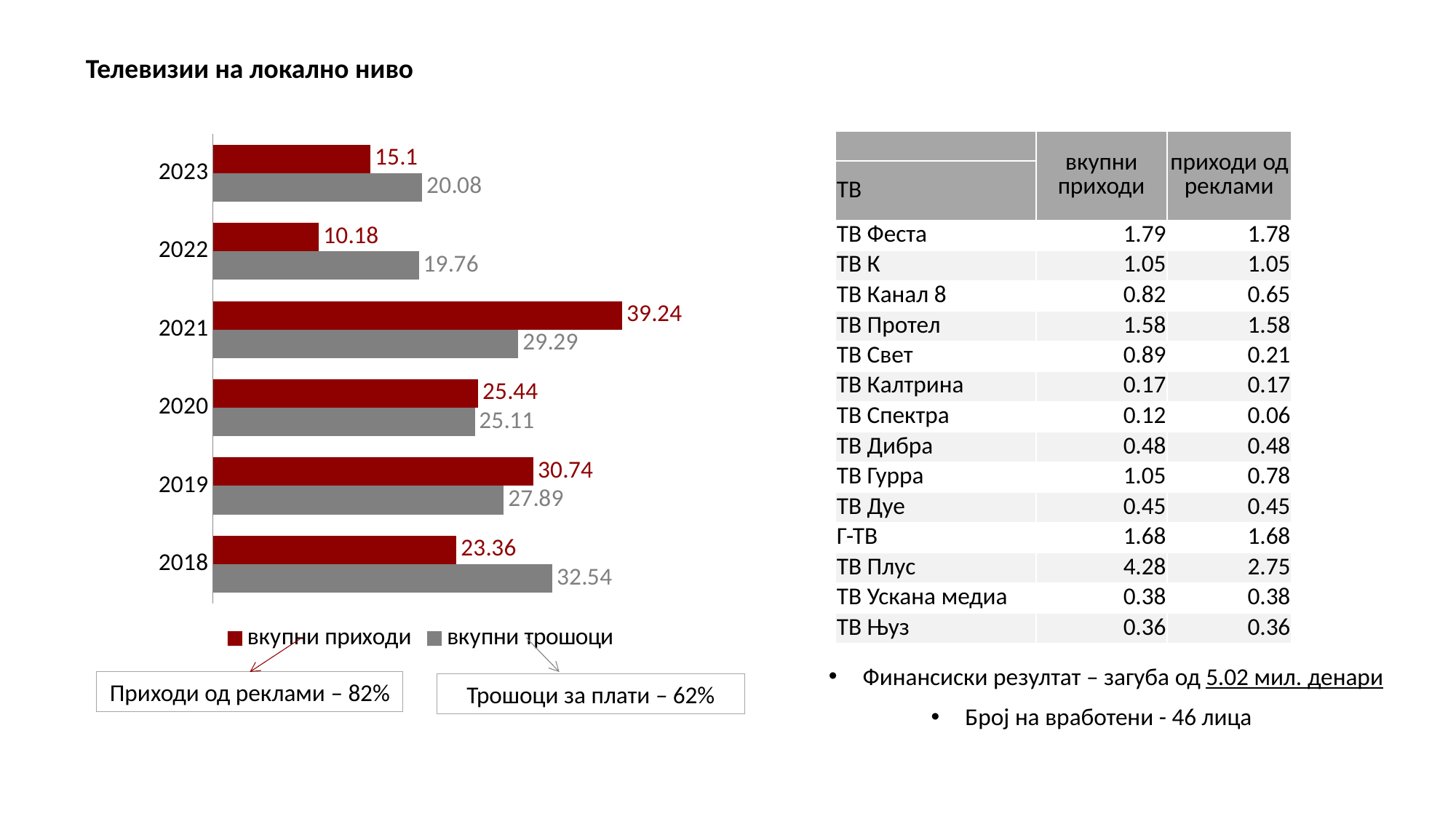
What is the value of вкупни трошоци for 2018? 32.54 What is the value of вкупни приходи for 2022? 10.18 How many series does the chart legend list? 2 In 2019, which is larger: вкупни приходи or вкупни трошоци? вкупни приходи What type of chart is shown on the slide? bar chart How many years are shown on the chart? 6 What is the difference between вкупни приходи and вкупни трошоци in 2023? 4.98 Which series is shown in dark red on the chart? вкупни приходи What is the value of вкупни приходи for 2021? 39.24 Which year has the highest вкупни приходи? 2021 Which year has the highest вкупни трошоци? 2018 Which year has the lowest вкупни приходи? 2022